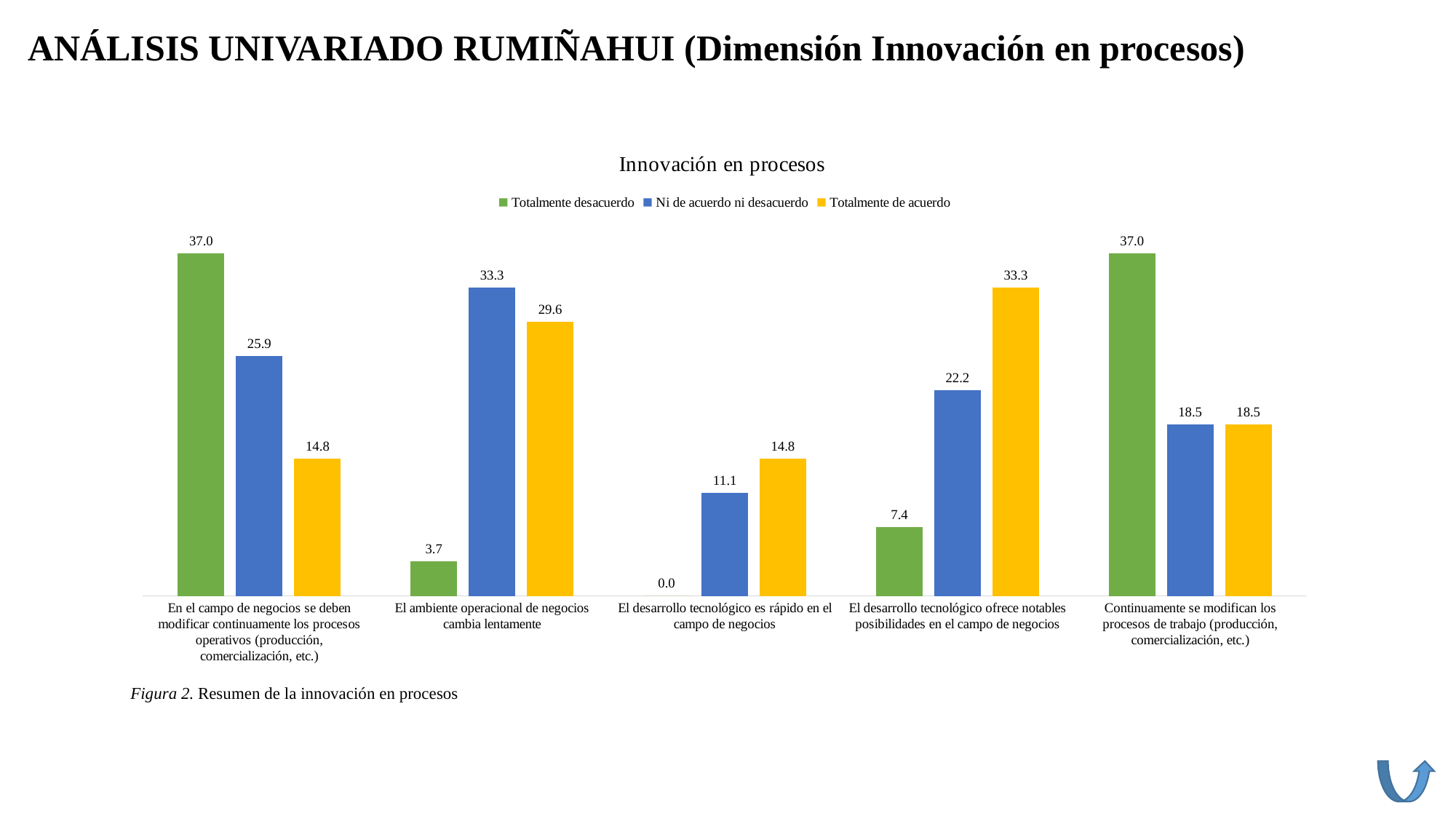
What is the difference between the "Totalmente desacuerdo" and "Totalmente de acuerdo" values for "En el campo de negocios se deben modificar continuamente los procesos operativos (producción, comercialización, etc.)"? 22.2 Which colour represents the "Totalmente de acuerdo" series? Yellow How many categories are shown on the x axis? 5 What is the value for "Totalmente desacuerdo" for "El ambiente operacional de negocios cambia lentamente"? 3.7 What is the value for "Totalmente de acuerdo" for "El desarrollo tecnológico ofrece notables posibilidades en el campo de negocios"? 33.3 How many series does the legend list? 3 Which category has the lowest value for "Totalmente desacuerdo"? El desarrollo tecnológico es rápido en el campo de negocios Which category has the highest value for "Ni de acuerdo ni desacuerdo"? El ambiente operacional de negocios cambia lentamente What is the value for "Ni de acuerdo ni desacuerdo" for "El desarrollo tecnológico es rápido en el campo de negocios"? 11.1 What kind of chart is shown on the slide? Bar chart What is the title of the chart? Innovación en procesos For "El desarrollo tecnológico ofrece notables posibilidades en el campo de negocios", which is larger: "Ni de acuerdo ni desacuerdo" or "Totalmente de acuerdo"? Totalmente de acuerdo